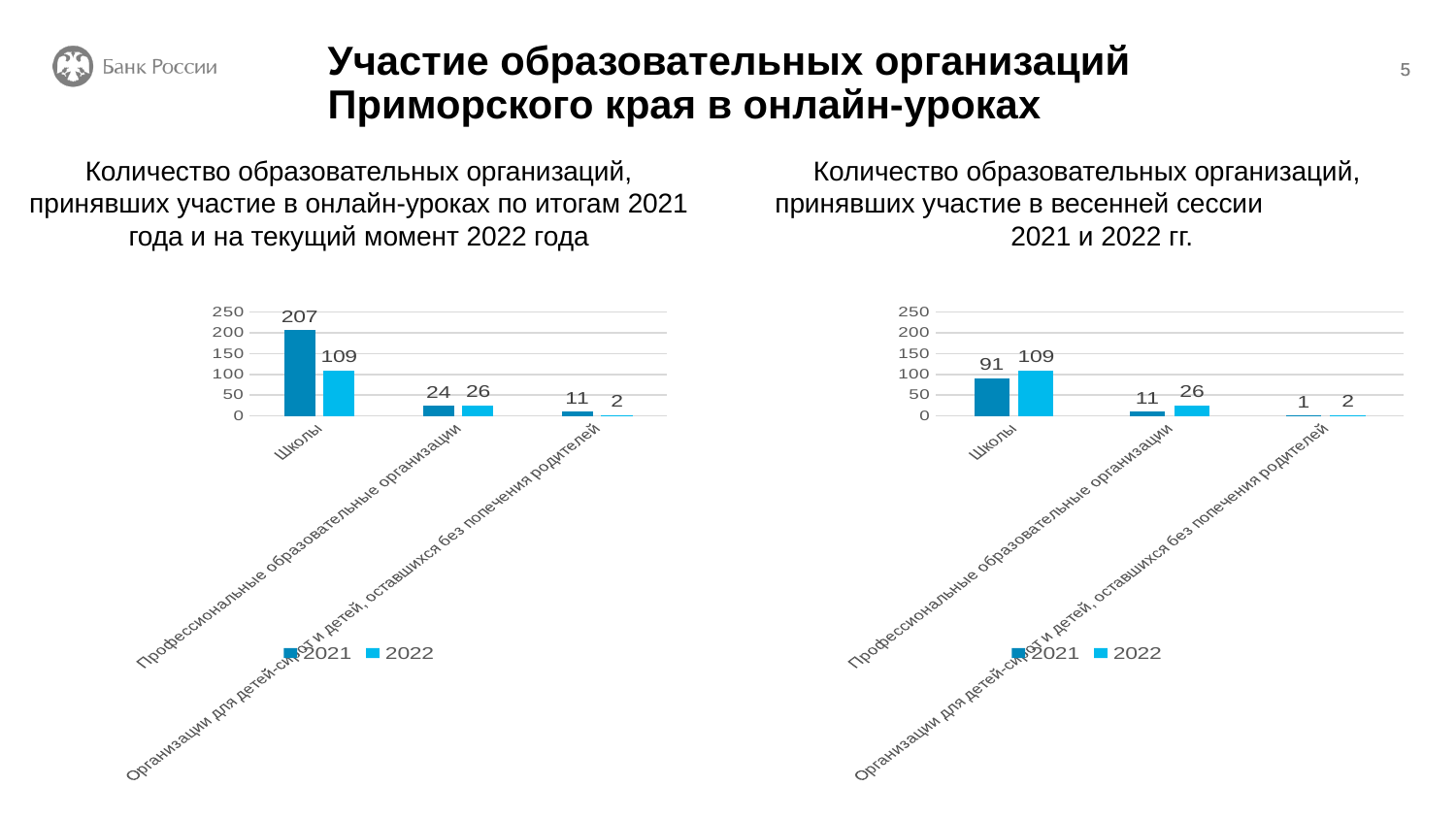
In the left chart, what is the difference between the 2021 and 2022 values for Школы? 98 In the right chart, which category has the lowest value for 2022? Организации для детей-сирот и детей, оставшихся без попечения родителей In the right chart, what is the difference between the 2022 and 2021 values for Профессиональные образовательные организации? 15 In the left chart, what is the value for Школы in 2021? 207 What type of chart is the left chart? Bar chart In the right chart, what is the value for Школы in 2022? 109 In the left chart, what is the value for Профессиональные образовательные организации in 2022? 26 How many series does the legend of the left chart list? 2 How many categories are shown on the x axis of the right chart? 3 In the right chart, what is the value for Организации для детей-сирот и детей, оставшихся без попечения родителей in 2021? 1 In the right chart, which is larger for Школы: the 2021 value or the 2022 value? 2022 In the left chart, which category has the highest value for 2021? Школы